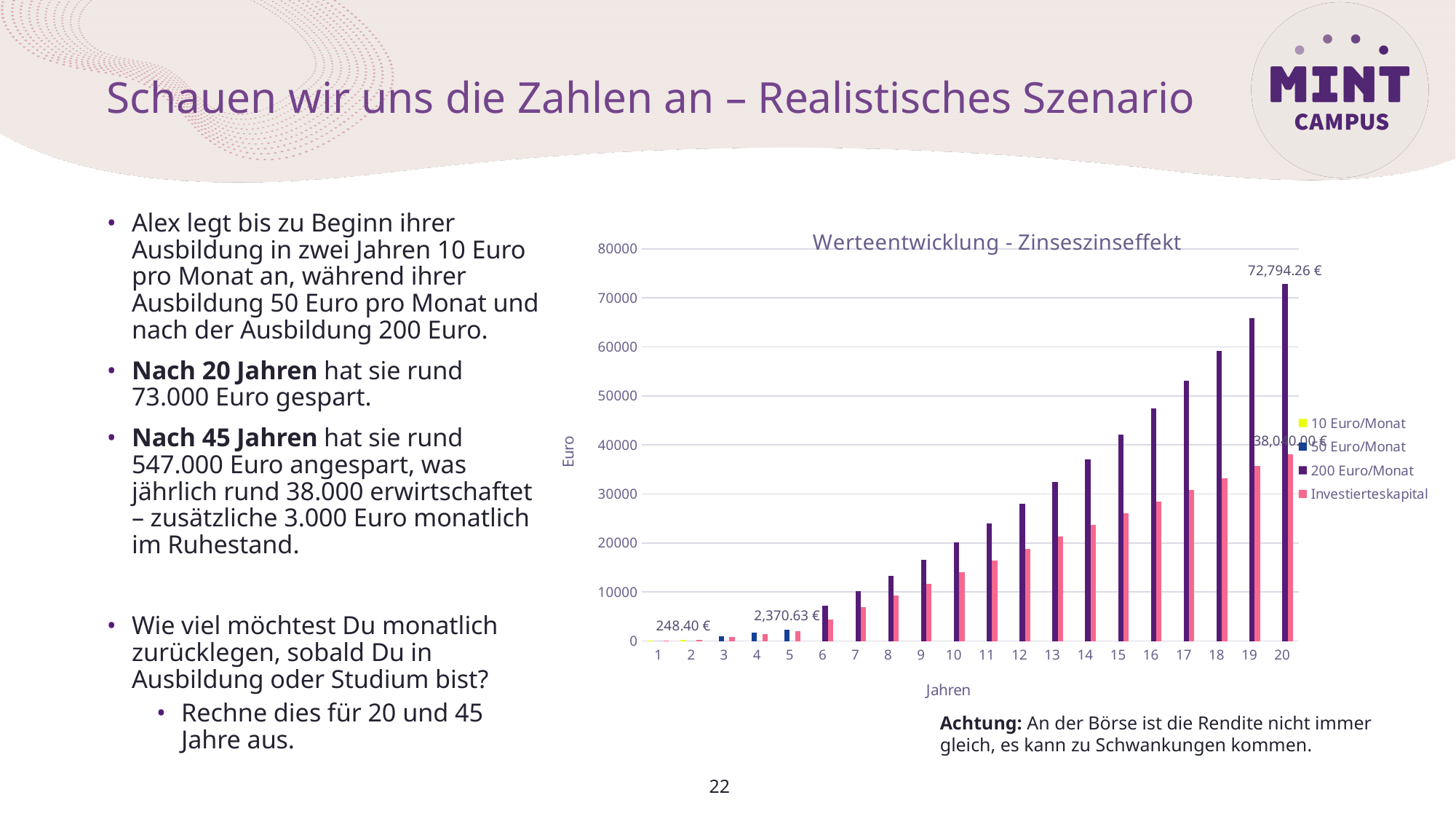
Is the value of the 200 Euro/Monat series in year 18 greater or less than 50000? greater In which year does the 200 Euro/Monat series reach its highest value? 20 Is the value of the 200 Euro/Monat series in year 10 greater or less than 30000? less What value is labelled on the chart in year 2? 248.40 € What is the title of the chart? Werteentwicklung - Zinseszinseffekt How many series does the chart legend list? 4 What value is labelled on the chart in year 5? 2,370.63 € How many years (categories) are shown on the x axis of the chart? 20 What is the value of the 200 Euro/Monat series in year 20? 72,794.26 € What kind of chart is shown on the slide? bar chart In year 20, which is larger: the 200 Euro/Monat series or the Investierteskapital series? 200 Euro/Monat Do the values of the 200 Euro/Monat series rise or fall from year 1 to year 20? rise